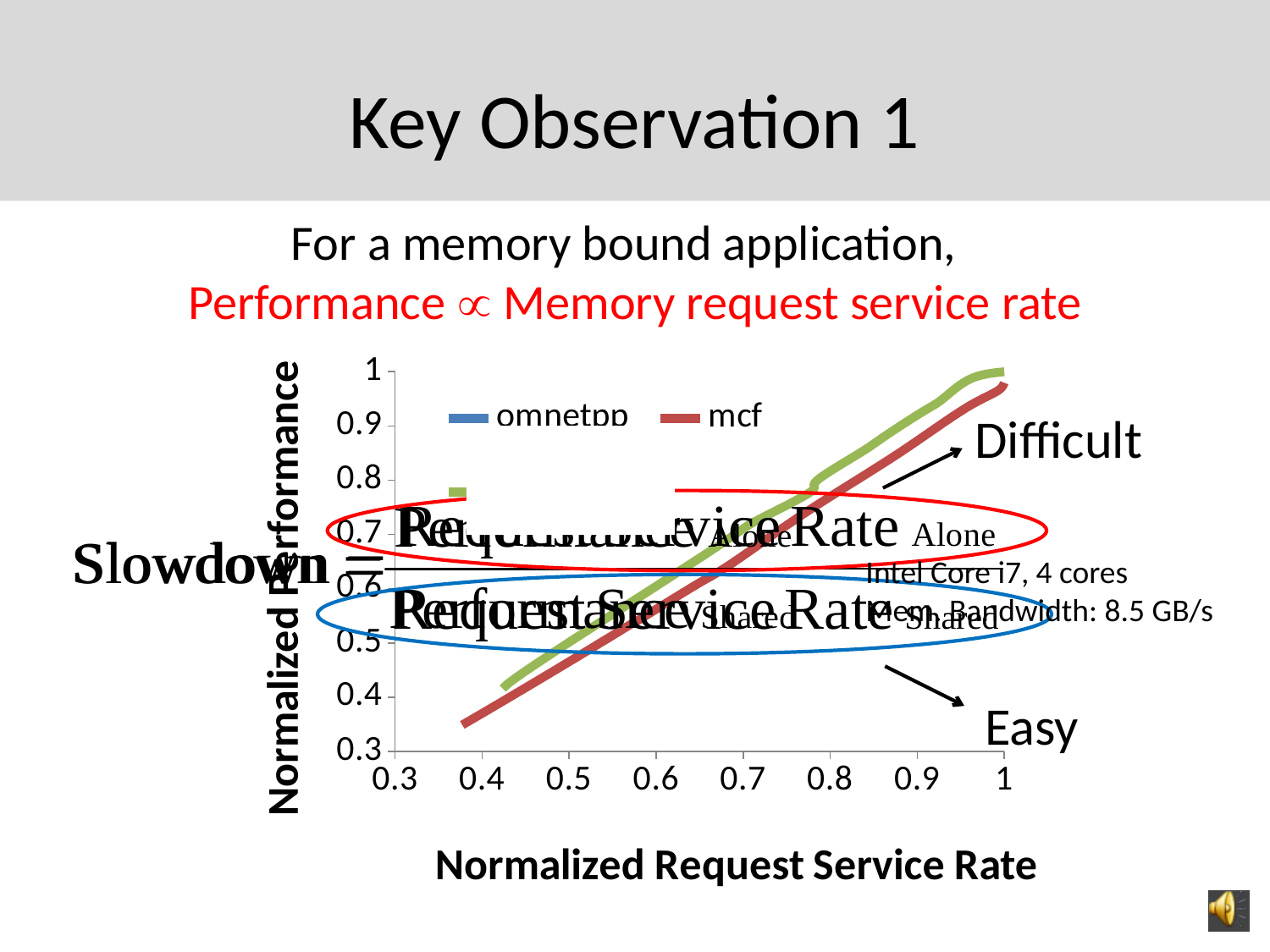
What is the lowest value shown on the chart's y axis? 0.3 Is the normalized performance of mcf at a normalized request service rate of 0.4 greater or less than 0.5? less What is the title of the chart's x axis? Normalized Request Service Rate Is the normalized performance of mcf at a normalized request service rate of 1 greater or less than 0.9? greater Is the normalized performance of mcf at a normalized request service rate of 0.8 greater or less than 0.6? greater What is the highest value shown on the chart's x axis? 1 What kind of chart is shown on the slide? line chart Do the plotted values rise or fall as the normalized request service rate increases? rise